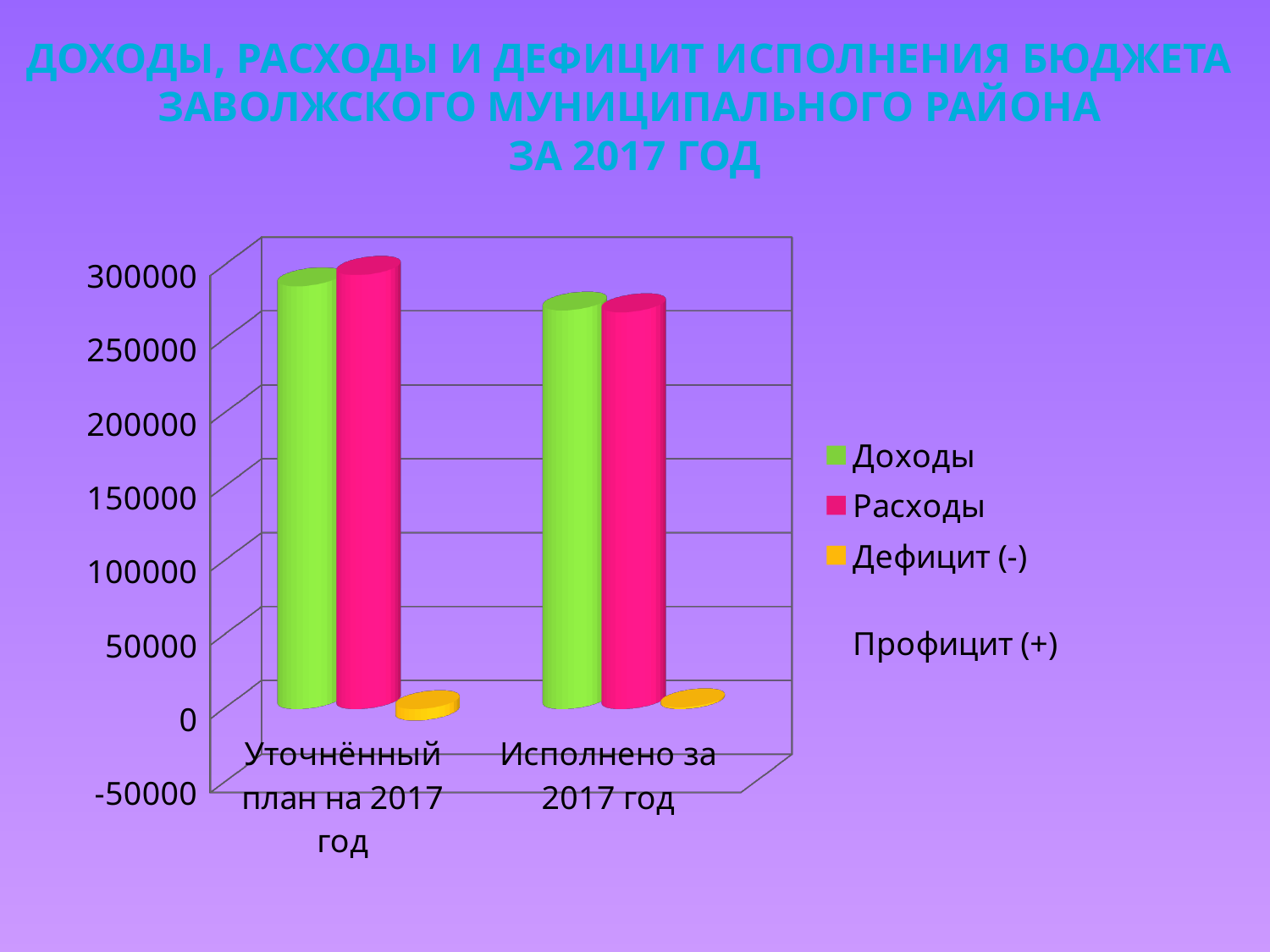
Is the value of Доходы for "Уточнённый план на 2017 год" greater or less than 250000? greater What kind of chart is shown on the slide? bar chart Which category has the higher value for Доходы: "Уточнённый план на 2017 год" or "Исполнено за 2017 год"? Уточнённый план на 2017 год What is the title of the slide? ДОХОДЫ, РАСХОДЫ И ДЕФИЦИТ ИСПОЛНЕНИЯ БЮДЖЕТА ЗАВОЛЖСКОГО МУНИЦИПАЛЬНОГО РАЙОНА ЗА 2017 ГОД Is the value of Расходы for "Уточнённый план на 2017 год" greater or less than 250000? greater Do the values of Расходы rise or fall from "Уточнённый план на 2017 год" to "Исполнено за 2017 год"? fall Is the value of Расходы for "Исполнено за 2017 год" greater or less than 300000? less Which series is shown in green in the chart? Доходы How many categories are shown on the x axis of the chart? 2 How many series does the chart's legend list? 3